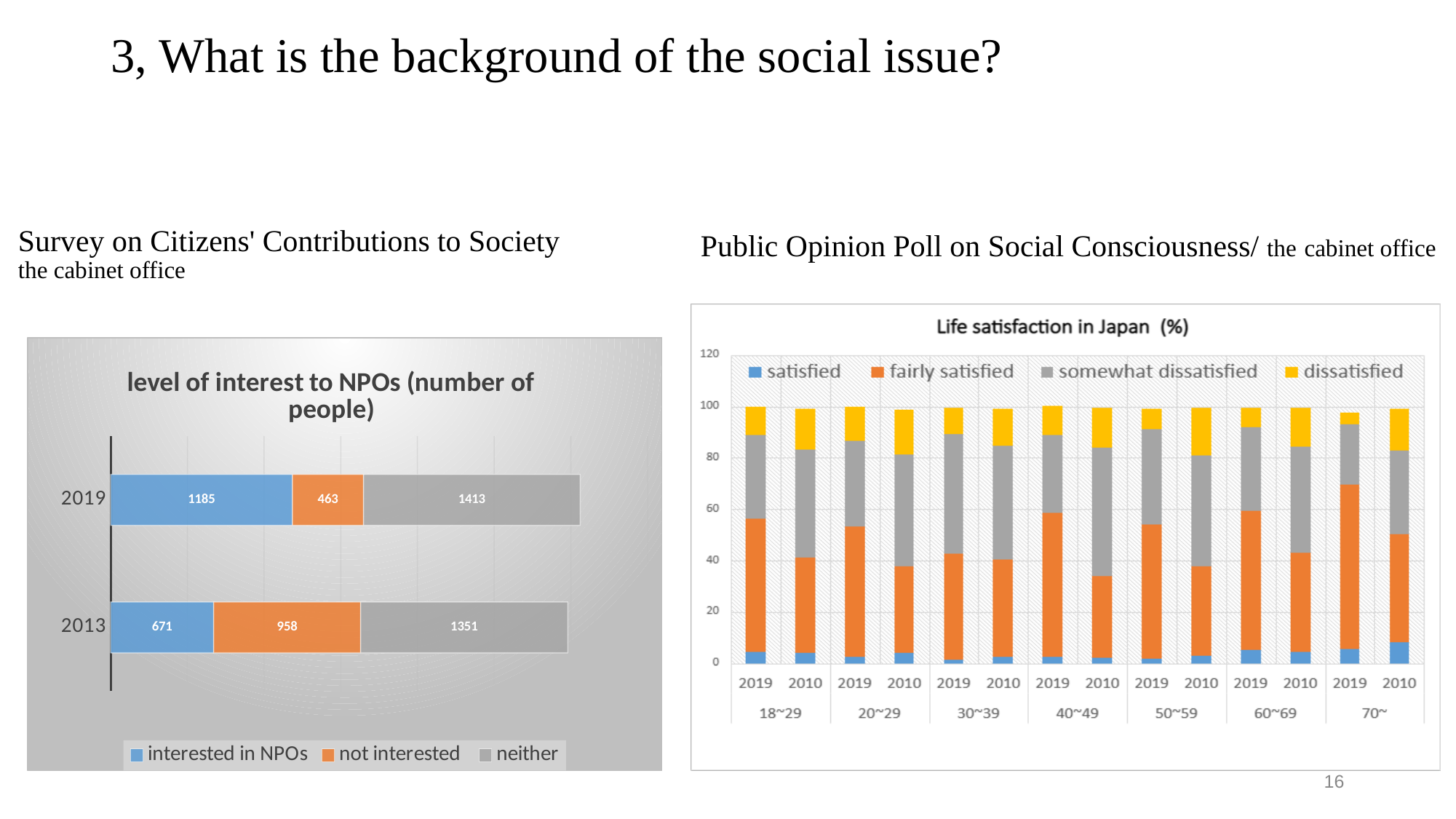
In the 'level of interest to NPOs' chart, which year has the larger 'not interested' value, 2019 or 2013? 2013 In the 'level of interest to NPOs' chart, what is the total of the 2019 stacked bar? 3061 In the 'level of interest to NPOs' chart, what is the total of the 2013 stacked bar? 2980 How many series does the legend of the 'level of interest to NPOs' chart list? 3 How many age groups are shown on the x axis of the 'Life satisfaction in Japan (%)' chart? 7 In the 'level of interest to NPOs' chart, what is the difference between the number interested in NPOs in 2019 and in 2013? 514 In the 'level of interest to NPOs' chart, what is the 'neither' value for 2019? 1413 What kind of chart is 'Life satisfaction in Japan (%)'? Stacked bar chart In the 'level of interest to NPOs' chart, how many people were not interested in 2013? 958 How many series does the legend of the 'Life satisfaction in Japan (%)' chart list? 4 In the 'level of interest to NPOs' chart, which segment of the 2013 bar is the smallest? interested in NPOs In the 'level of interest to NPOs' chart, how many people were interested in NPOs in 2019? 1185